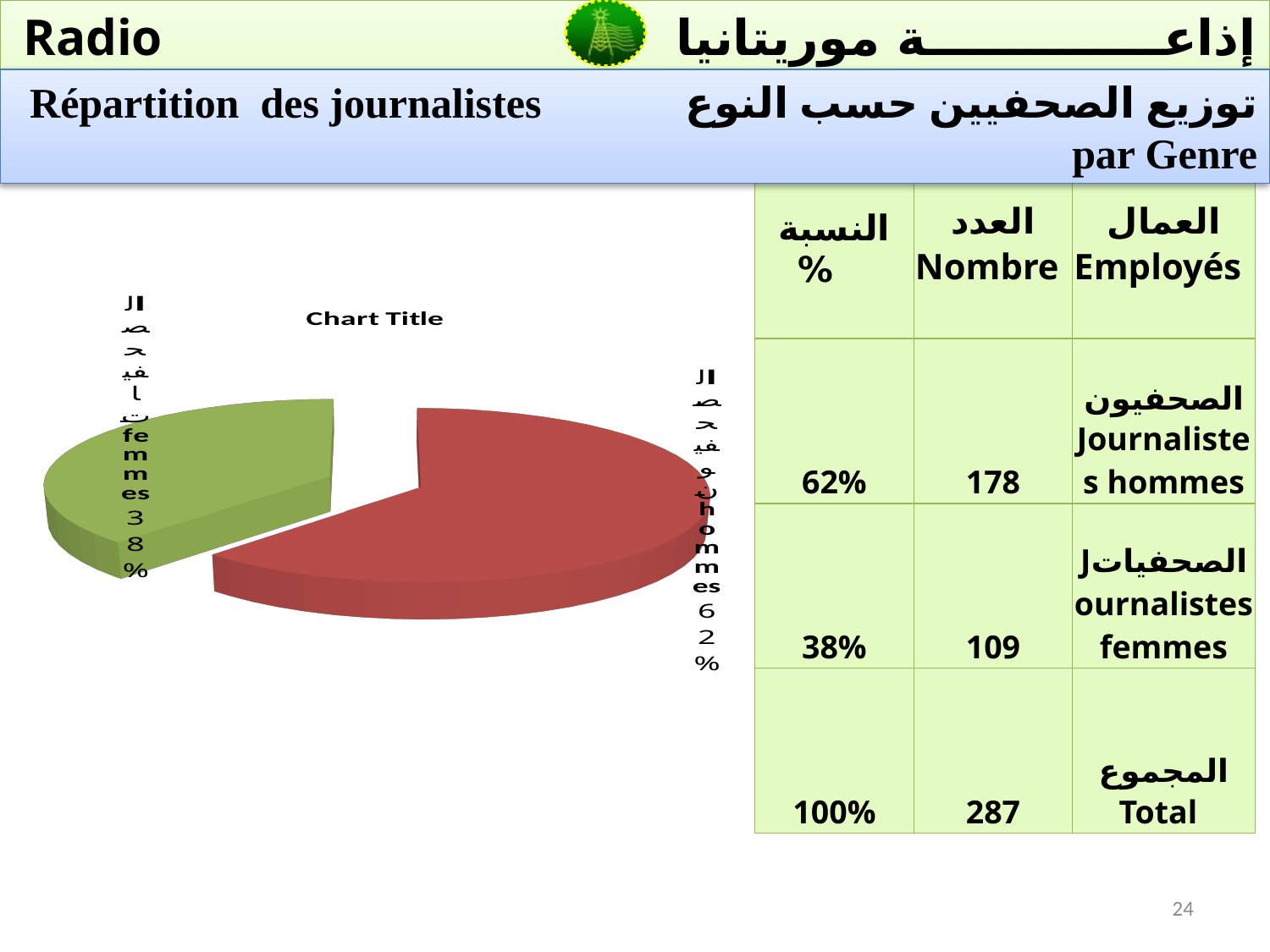
What is the title printed above the pie chart? Chart Title Which is larger in the pie chart, the share for hommes or the share for femmes? hommes What is the difference in percentage points between the hommes slice and the femmes slice? 24% What share of the pie does the "femmes" slice represent? 38% What colour is the "femmes" slice of the pie chart? green Which slice of the pie chart is the smallest? femmes What kind of chart is shown on the slide? pie chart How many slices does the pie chart have? 2 What share of the pie does the "hommes" slice represent? 62% Which slice of the pie chart is the largest? hommes